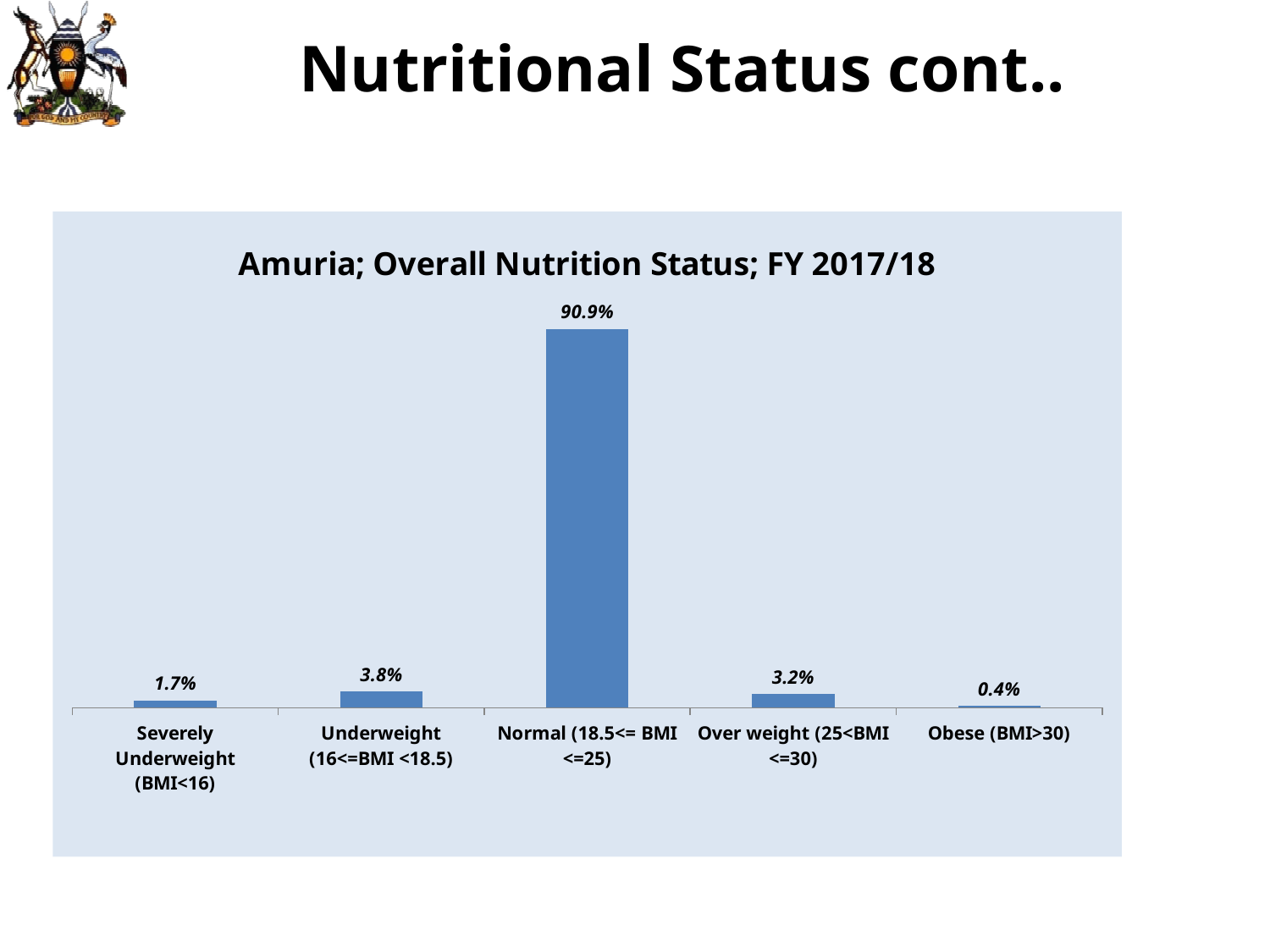
What is the value for Severely Underweight (BMI<16)? 1.7% What kind of chart is shown on the slide? Bar chart Which category has the highest value? Normal (18.5<= BMI <=25) What is the value for Obese (BMI>30)? 0.4% Which is larger, the value for Underweight (16<=BMI <18.5) or the value for Severely Underweight (BMI<16)? Underweight (16<=BMI <18.5) How many categories are shown on the chart? 5 What is the difference between the values for Underweight (16<=BMI <18.5) and Over weight (25<BMI <=30)? 0.6% What is the value for Normal (18.5<= BMI <=25)? 90.9% What is the title of the chart? Amuria; Overall Nutrition Status; FY 2017/18 What is the value for Underweight (16<=BMI <18.5)? 3.8% Which category has the lowest value? Obese (BMI>30) What is the difference between the values for Normal (18.5<= BMI <=25) and Obese (BMI>30)? 90.5%